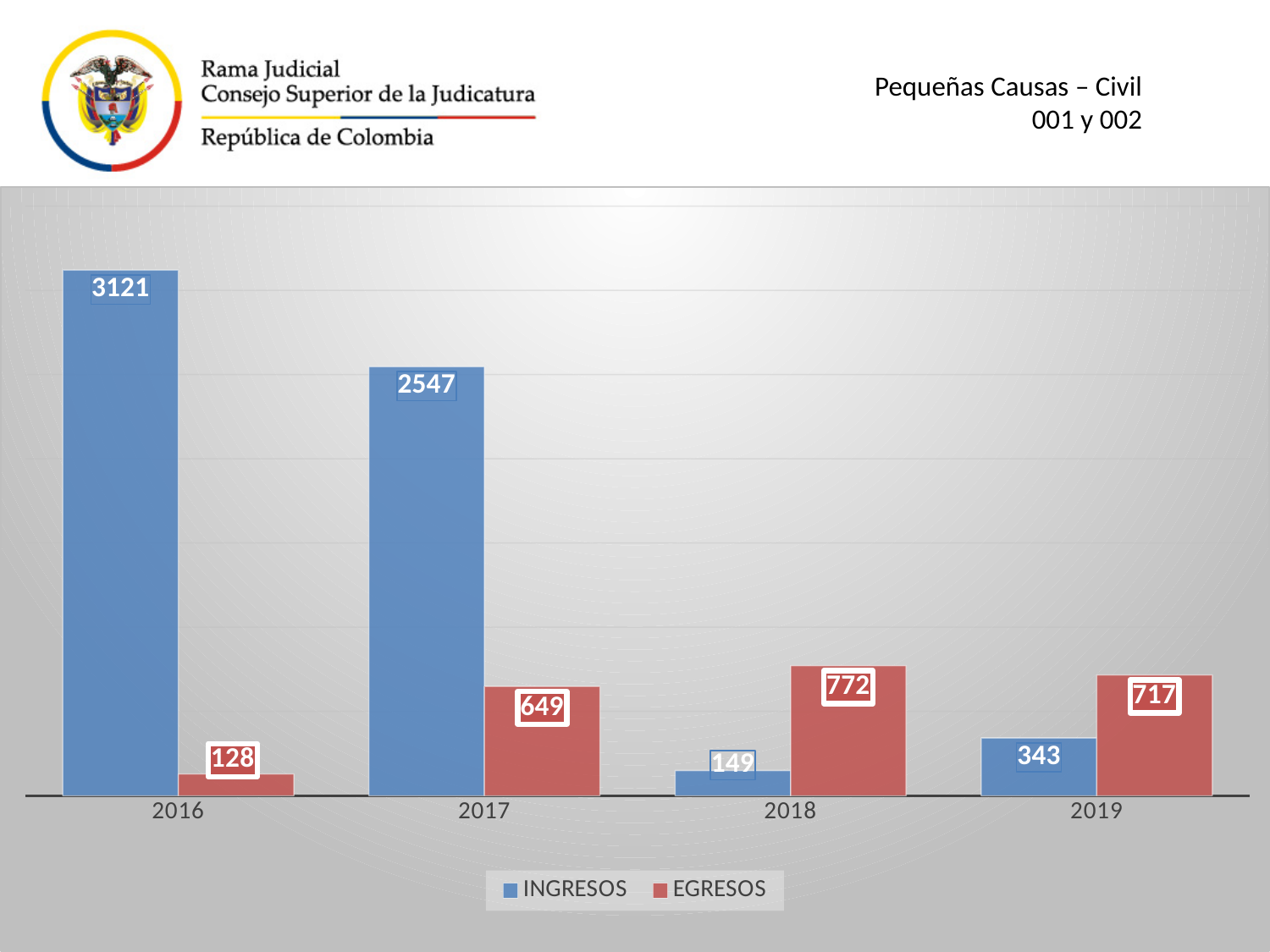
What kind of chart is shown on the slide? Bar chart Do the INGRESOS values rise or fall from 2016 to 2018? Fall How many years are shown on the x axis? 4 What is the EGRESOS value for 2018? 772 How many series does the legend list? 2 What is the difference between INGRESOS and EGRESOS in 2017? 1898 Which is larger in 2019, INGRESOS or EGRESOS? EGRESOS Which year has the lowest INGRESOS value? 2018 Which year has the lowest EGRESOS value? 2016 Which year has the highest INGRESOS value? 2016 What is the INGRESOS value for 2019? 343 What is the INGRESOS value for 2016? 3121